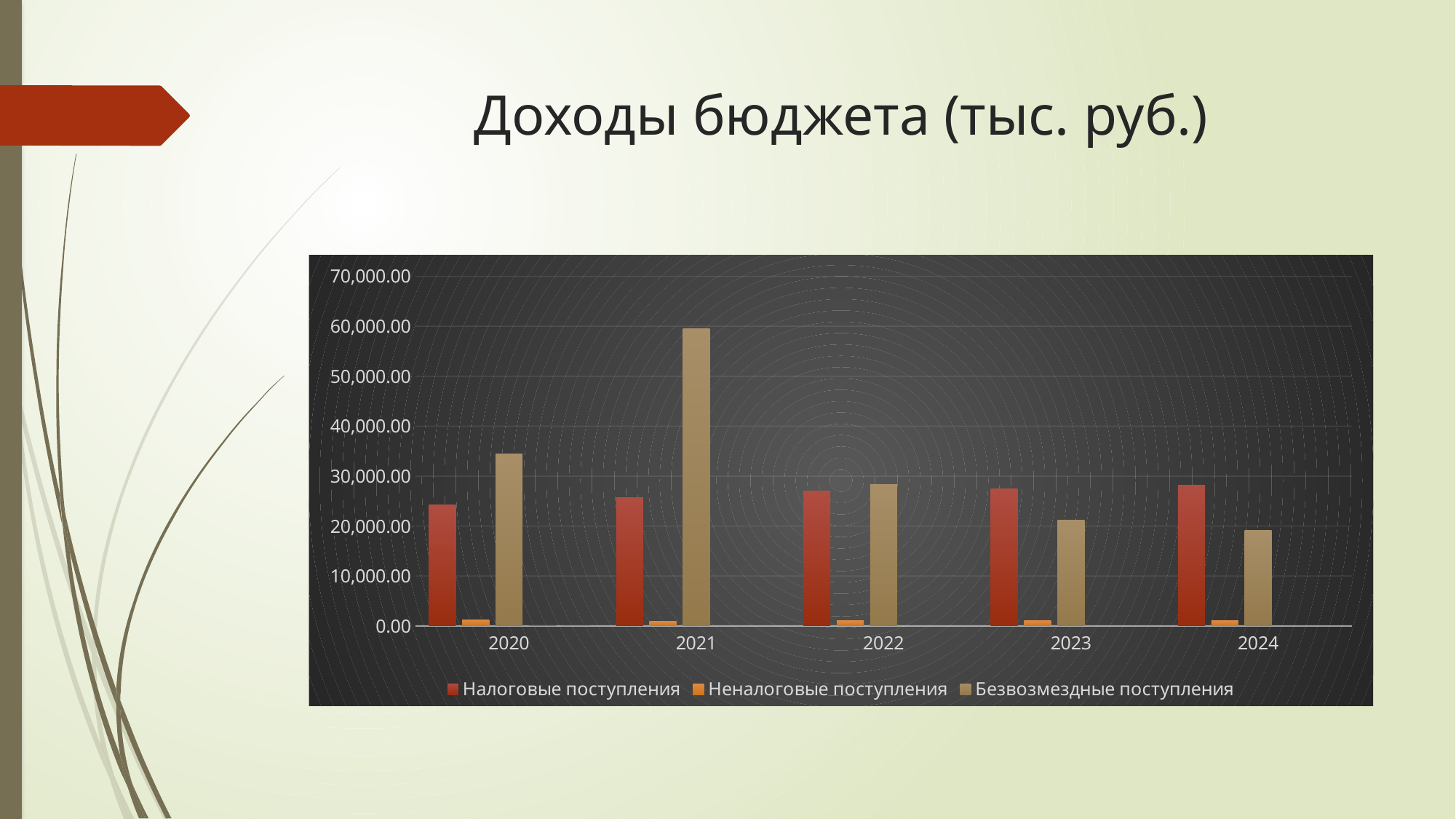
In which year is the value for Безвозмездные поступления the highest? 2021 How many years are shown on the x axis of the chart? 5 What is the title of the slide containing the chart? Доходы бюджета (тыс. руб.) In which year is the value for Безвозмездные поступления the lowest? 2024 How many series does the chart legend list? 3 Is the value for Налоговые поступления in 2020 greater or less than 30,000.00? less Is the value for Безвозмездные поступления in 2022 greater or less than 30,000.00? less In 2020, which is larger: Налоговые поступления or Безвозмездные поступления? Безвозмездные поступления Do the values for Налоговые поступления rise or fall from 2020 to 2024? Rise Is the value for Безвозмездные поступления in 2021 greater or less than 50,000.00? greater What kind of chart is shown on the slide? Bar chart In 2023, which is larger: Налоговые поступления or Безвозмездные поступления? Налоговые поступления